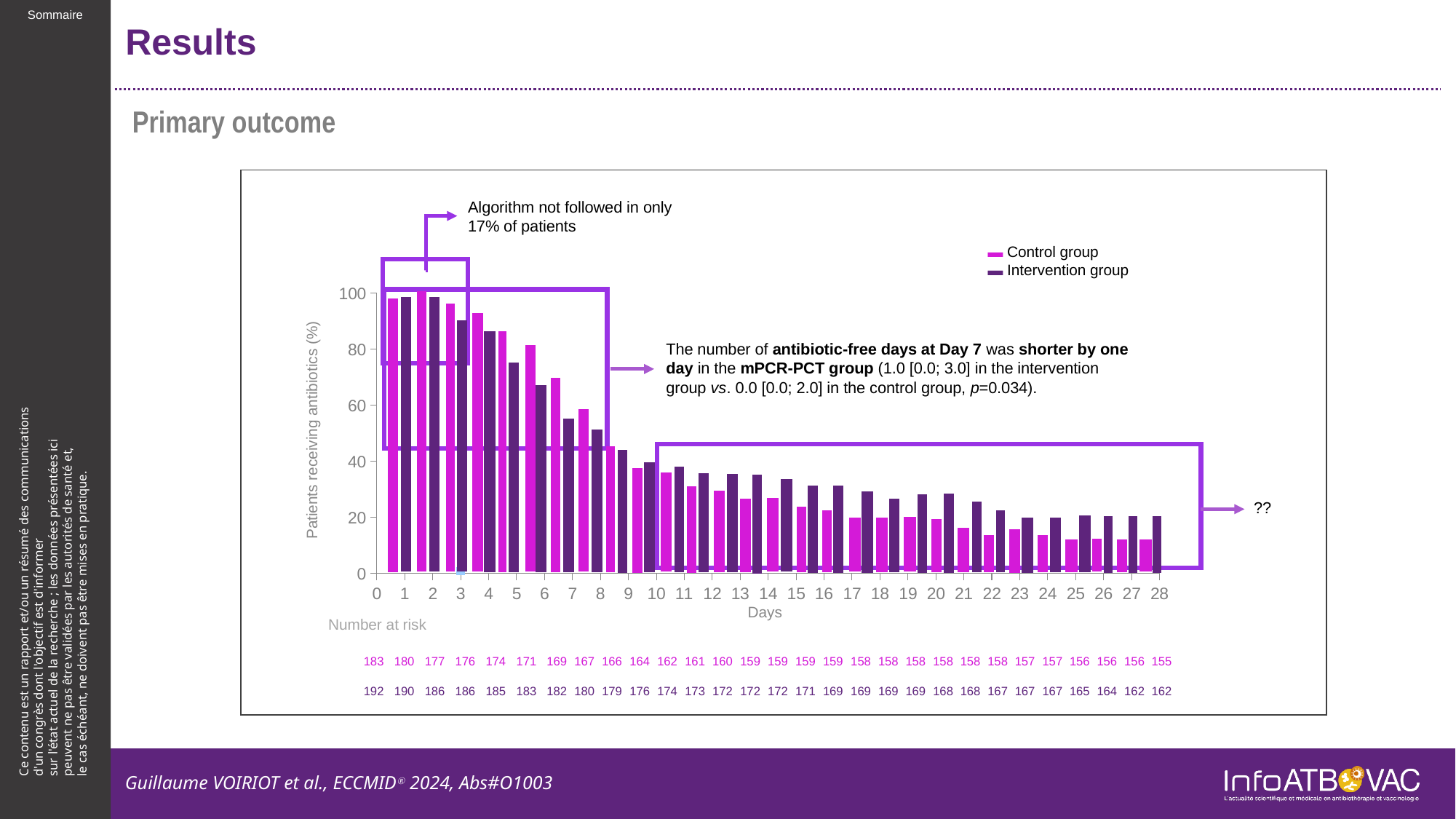
At day 28, which group has the higher percentage of patients receiving antibiotics? Intervention group What is the number at risk for the Control group at day 0? 183 How many days (x-axis categories) are plotted, from day 0 to day 28? 29 Is the value for the Control group at day 0 greater or less than 80? greater How many series does the legend list? 2 Is the value for the Control group at day 10 greater or less than 60? less Do the percentages of patients receiving antibiotics rise or fall as the days increase? fall What are the two groups listed in the legend? Control group and Intervention group Is the value for the Intervention group at day 28 greater or less than 40? less What kind of chart is shown on the slide? bar chart What is the number at risk for the Intervention group at day 28? 162 What is the label of the y axis? Patients receiving antibiotics (%)